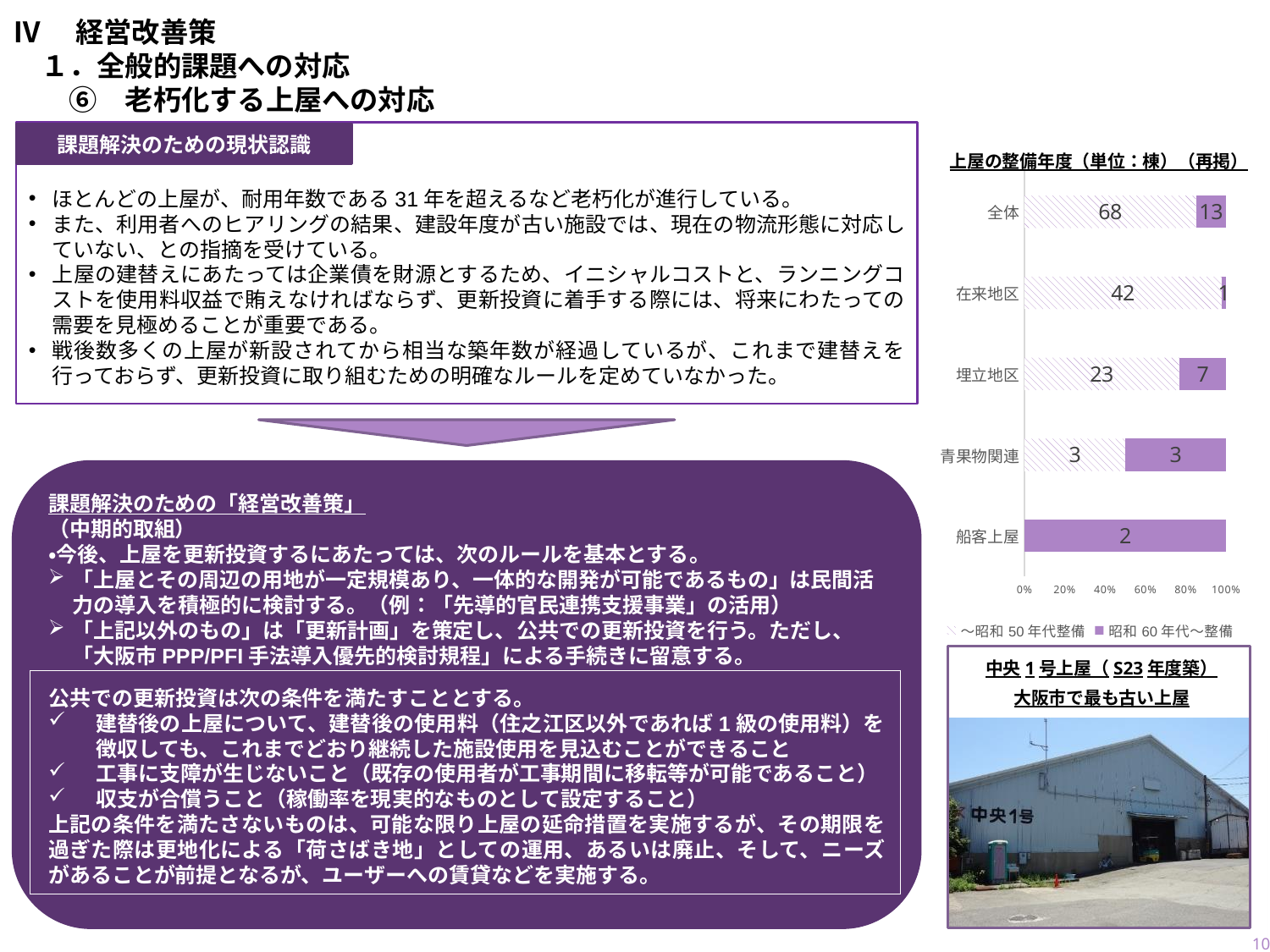
In the 上屋の整備年度 chart, what is the total number of 棟 for 在来地区 across both series? 43 In the 上屋の整備年度 chart, which category has the highest value for ～昭和50年代整備? 全体 In the 上屋の整備年度 chart, what is the value of 昭和60年代～整備 for 埋立地区? 7 In the 上屋の整備年度 chart, what is the value of ～昭和50年代整備 for 全体? 68 How many categories are plotted in the 上屋の整備年度 chart? 5 How many series does the legend of the 上屋の整備年度 chart list? 2 In the 上屋の整備年度 chart, what is the value of 昭和60年代～整備 for 全体? 13 In the 上屋の整備年度 chart, what is the difference between ～昭和50年代整備 and 昭和60年代～整備 for 埋立地区? 16 In the 上屋の整備年度 chart, which is larger for 青果物関連: ～昭和50年代整備 or 昭和60年代～整備? They are equal (3 each) In the 上屋の整備年度 chart, what is the value of 昭和60年代～整備 for 船客上屋? 2 What type of chart is shown under the title 上屋の整備年度（単位：棟）（再掲）? stacked bar chart In the 上屋の整備年度 chart, what is the value of ～昭和50年代整備 for 在来地区? 42